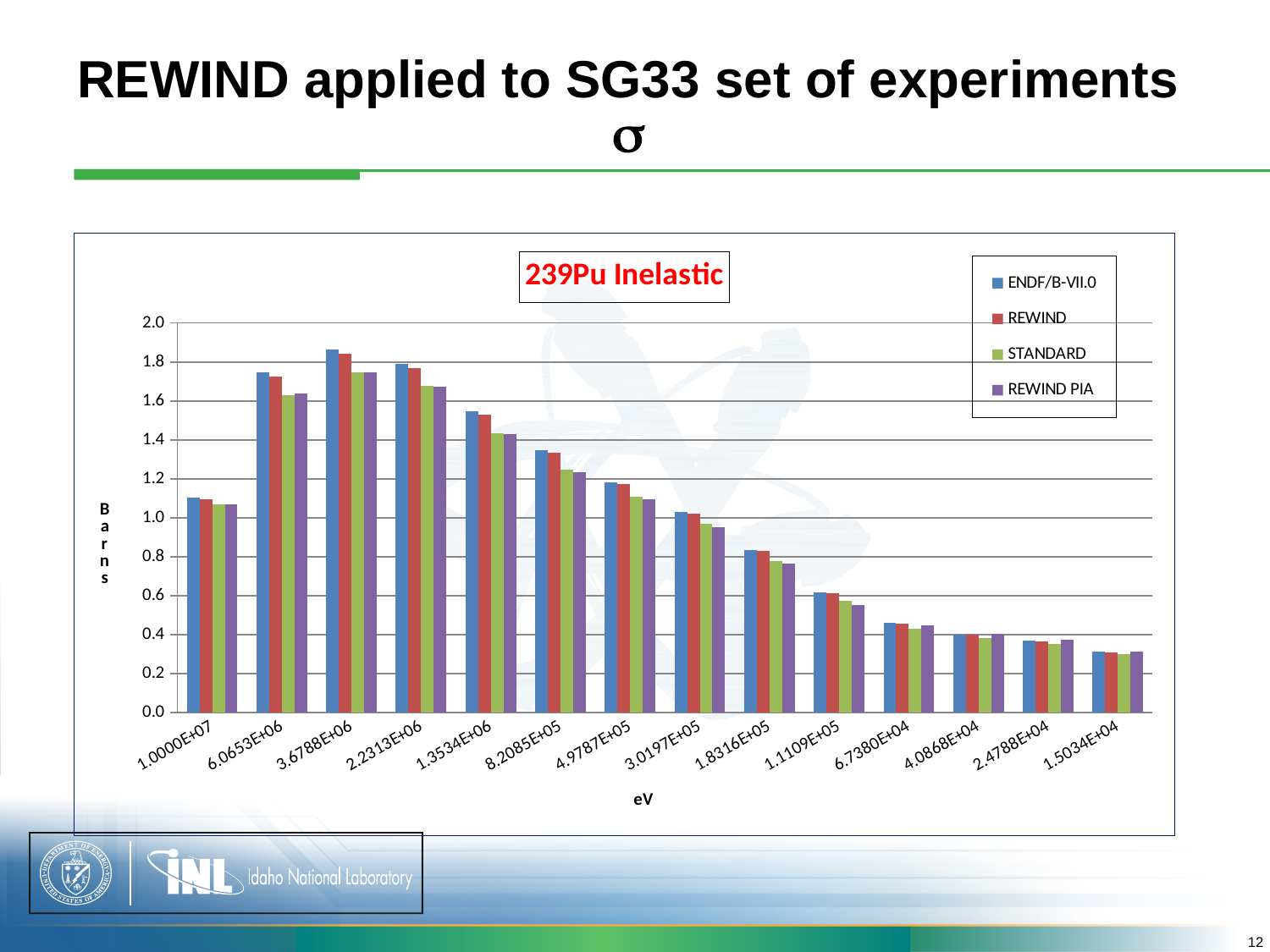
How many series does the legend list? 4 Which energy category has the lowest ENDF/B-VII.0 value? 1.5034E+04 How many energy categories are shown along the x axis? 14 Which is larger for ENDF/B-VII.0: the value at 1.0000E+07 or at 6.0653E+06? 6.0653E+06 What kind of chart is shown on the slide? bar chart From 3.6788E+06 onward, do the ENDF/B-VII.0 values rise or fall along the x axis? fall Is the STANDARD value for 1.5034E+04 greater or less than 0.4? less Which energy category has the highest ENDF/B-VII.0 value? 3.6788E+06 Is the ENDF/B-VII.0 value for 8.2085E+05 greater or less than 1.2? greater What is the title shown inside the chart? 239Pu Inelastic Is the ENDF/B-VII.0 value for 6.7380E+04 greater or less than 0.6? less